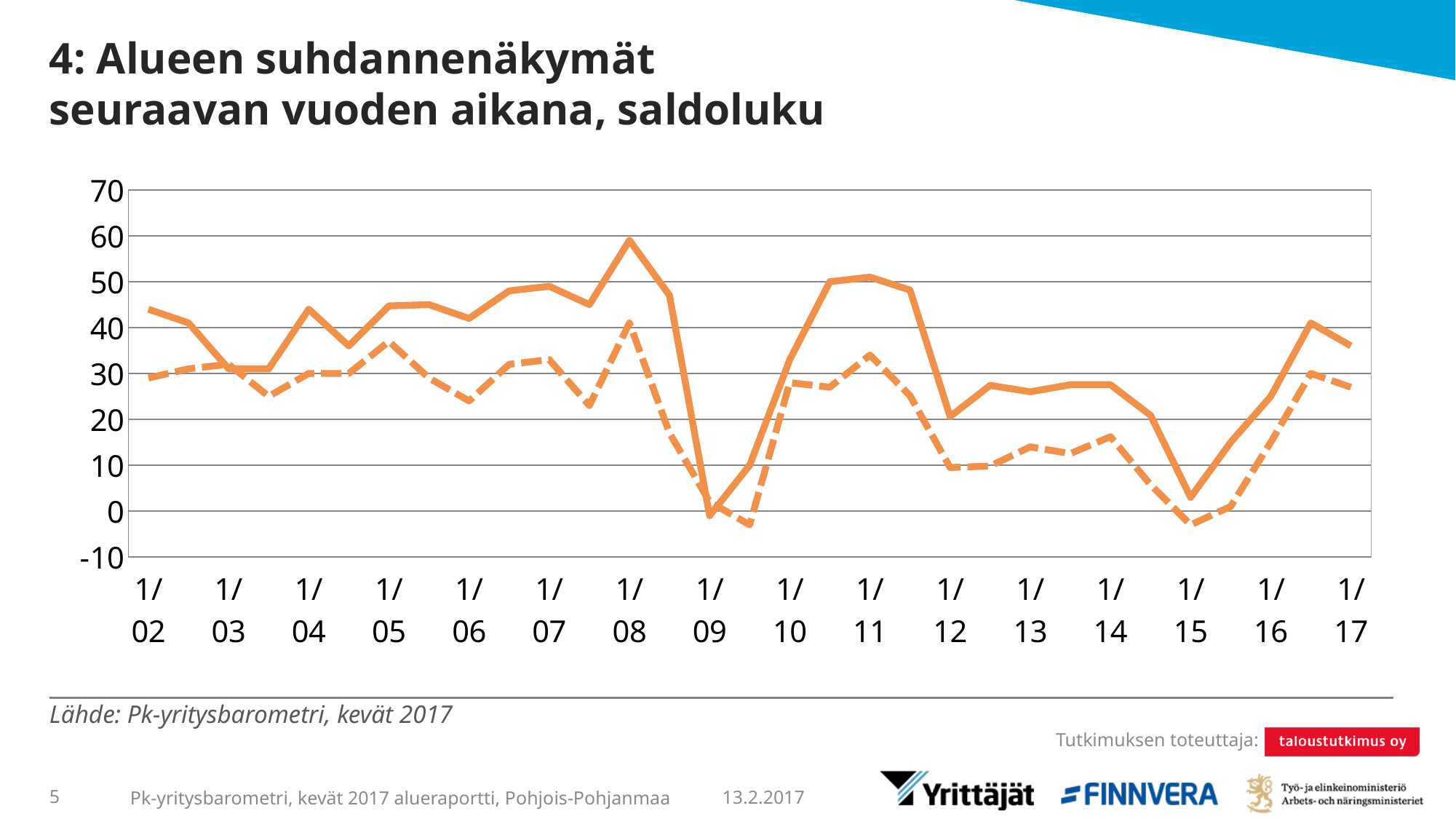
What kind of chart is shown on the slide? line chart How many lines are plotted in the chart? 2 At which x-axis label does the dashed line reach its highest value? 1/08 Which line has the higher value at 1/02, the solid line or the dashed line? the solid line Is the value of the solid line at 1/09 greater or less than 10? less Is the value of the dashed line at 1/15 greater or less than 0? less Is the value of the solid line at 1/17 greater or less than 30? greater What is the title of the chart on the slide? 4: Alueen suhdannenäkymät seuraavan vuoden aikana, saldoluku At which x-axis label does the solid line reach its highest value? 1/08 How many year labels are shown on the x axis of the chart? 16 Does the solid line rise or fall between 1/15 and 1/16? rise